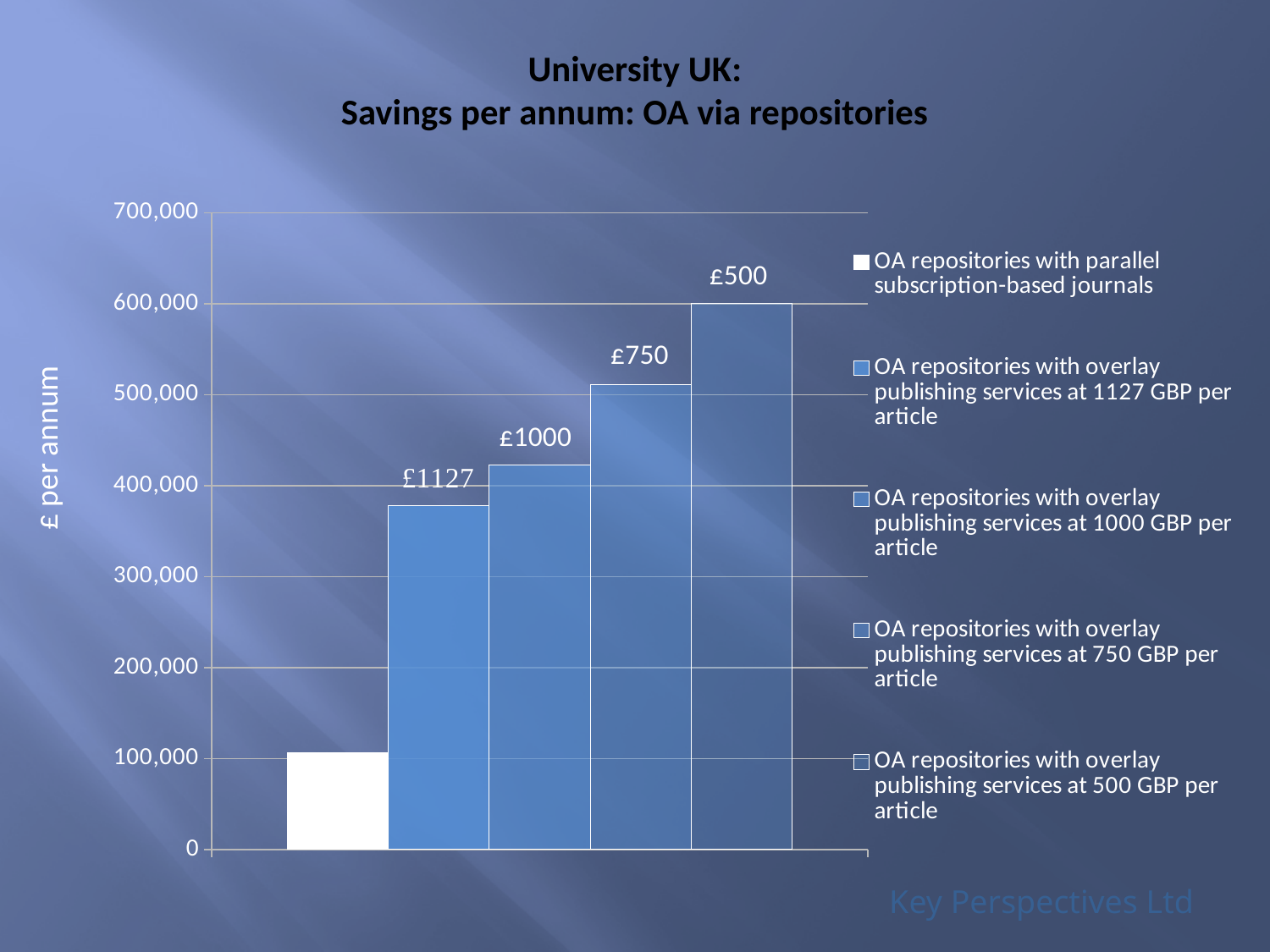
Do the bar values rise or fall from left to right across the chart? rise Which is larger: the savings for overlay publishing at 500 GBP per article or at 1127 GBP per article? 500 GBP per article How many bars are plotted in the chart? 5 What kind of chart is shown on the slide? bar chart Which series has the lowest savings per annum? OA repositories with parallel subscription-based journals How many series does the legend list? 5 Is the value for OA repositories with overlay publishing services at 1000 GBP per article greater or less than 500,000? less Is the value for OA repositories with parallel subscription-based journals greater or less than 200,000? less Is the value for OA repositories with overlay publishing services at 500 GBP per article greater or less than 500,000? greater Which series has the highest savings per annum? OA repositories with overlay publishing services at 500 GBP per article What is the label on the vertical axis of the chart? £ per annum